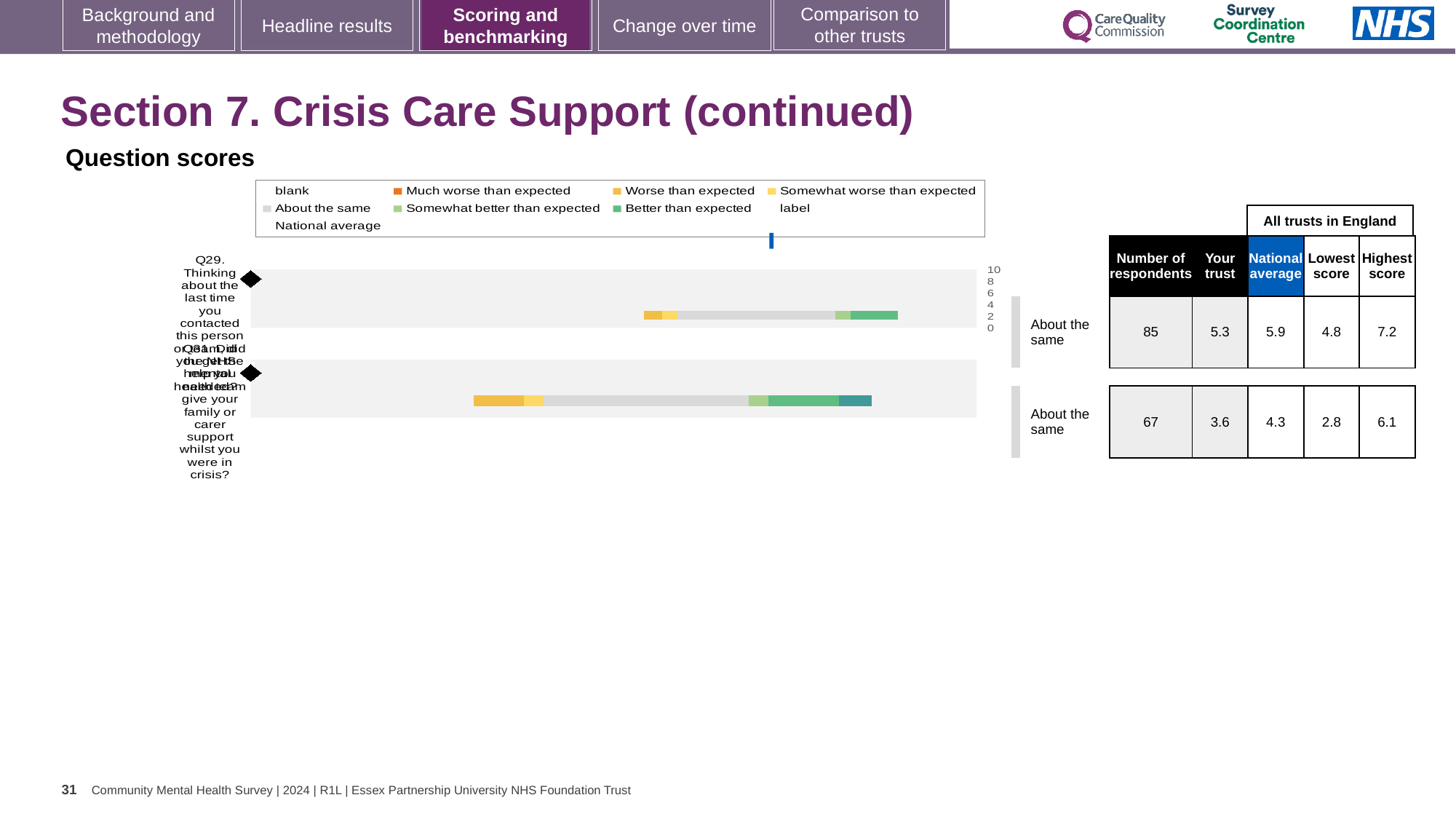
What is the highest score among all trusts in England for Q31? 6.1 What is the national average score for Q31? 4.3 What is the difference between the national average and the trust's score for Q29? 0.6 Which question has the higher 'Your trust' score, Q29 or Q31? Q29 What is the 'Your trust' score for Q29? 5.3 What is the difference between the highest and lowest scores for Q31? 3.3 How many respondents answered Q29? 85 How many questions are plotted in the chart? 2 Which question has more respondents? Q29 What is the heading above the chart? Question scores What benchmark category is the trust given for Q31? About the same What kind of chart is shown under 'Question scores'? bar chart